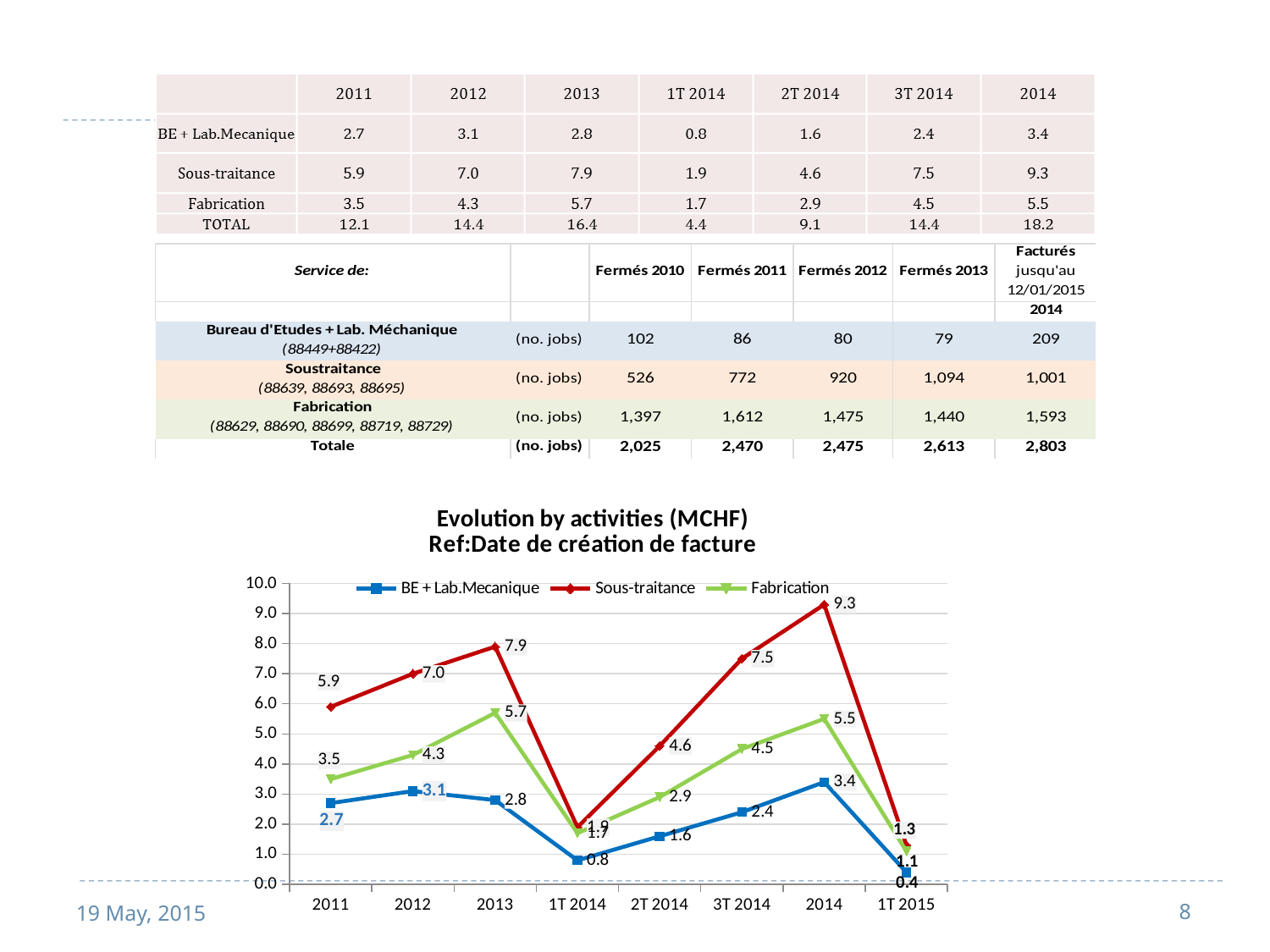
How many series does the chart legend list? 3 What is the difference between Sous-traitance and Fabrication in 2013? 2.2 What type of chart is shown on the slide? line chart How many points are plotted along the x axis of the chart? 8 What is the value for BE + Lab.Mecanique in 1T 2014? 0.8 Does the value for Sous-traitance rise or fall from 2011 to 2013? rise Which is larger in 3T 2014: Sous-traitance or Fabrication? Sous-traitance In which period does Sous-traitance reach its highest value? 2014 What is the value for Sous-traitance in 2014? 9.3 What is the value for Fabrication in 2013? 5.7 What is the title of the chart? Evolution by activities (MCHF) Ref:Date de création de facture In which period is the value for BE + Lab.Mecanique lowest? 1T 2015